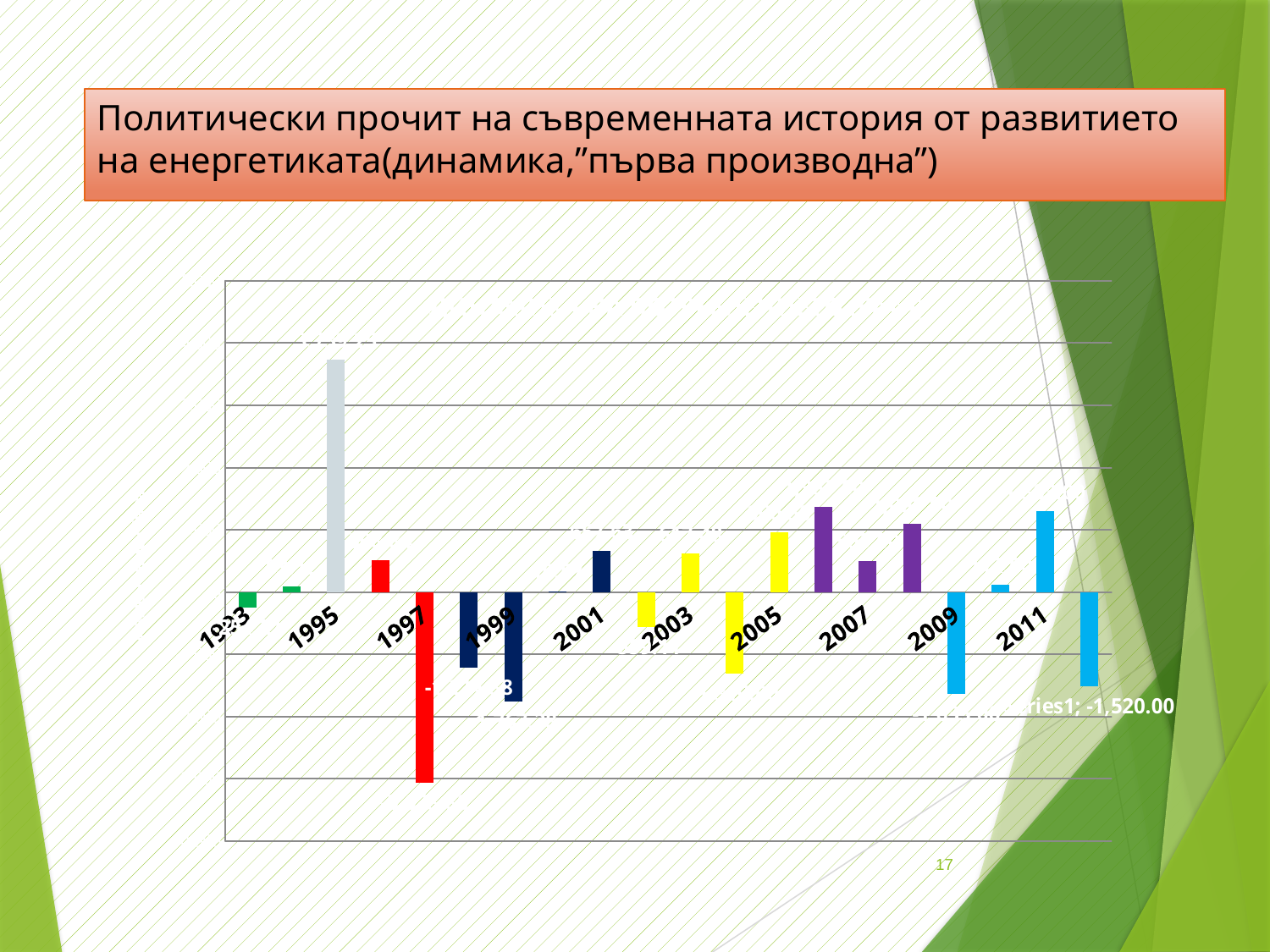
Which is larger, the value for 2005 or the value for 1997? 2005 What kind of chart is shown on the slide? bar chart Which year has the highest (tallest positive) bar in the chart? 1995 What value is printed in the readable data label at the lower right of the chart? -1,520.00 What is the first year label shown on the x axis? 1993 What colour is the tallest bar (1995) in the chart? gray What is the last year label shown on the x axis? 2011 Which year has the lowest (deepest negative) bar in the chart? 1997 Which is larger, the value for 1995 or the value for 2007? 1995 Which is larger, the value for 2001 or the value for 2007? 2001 What series name appears in the data label at the lower right of the chart? Series1